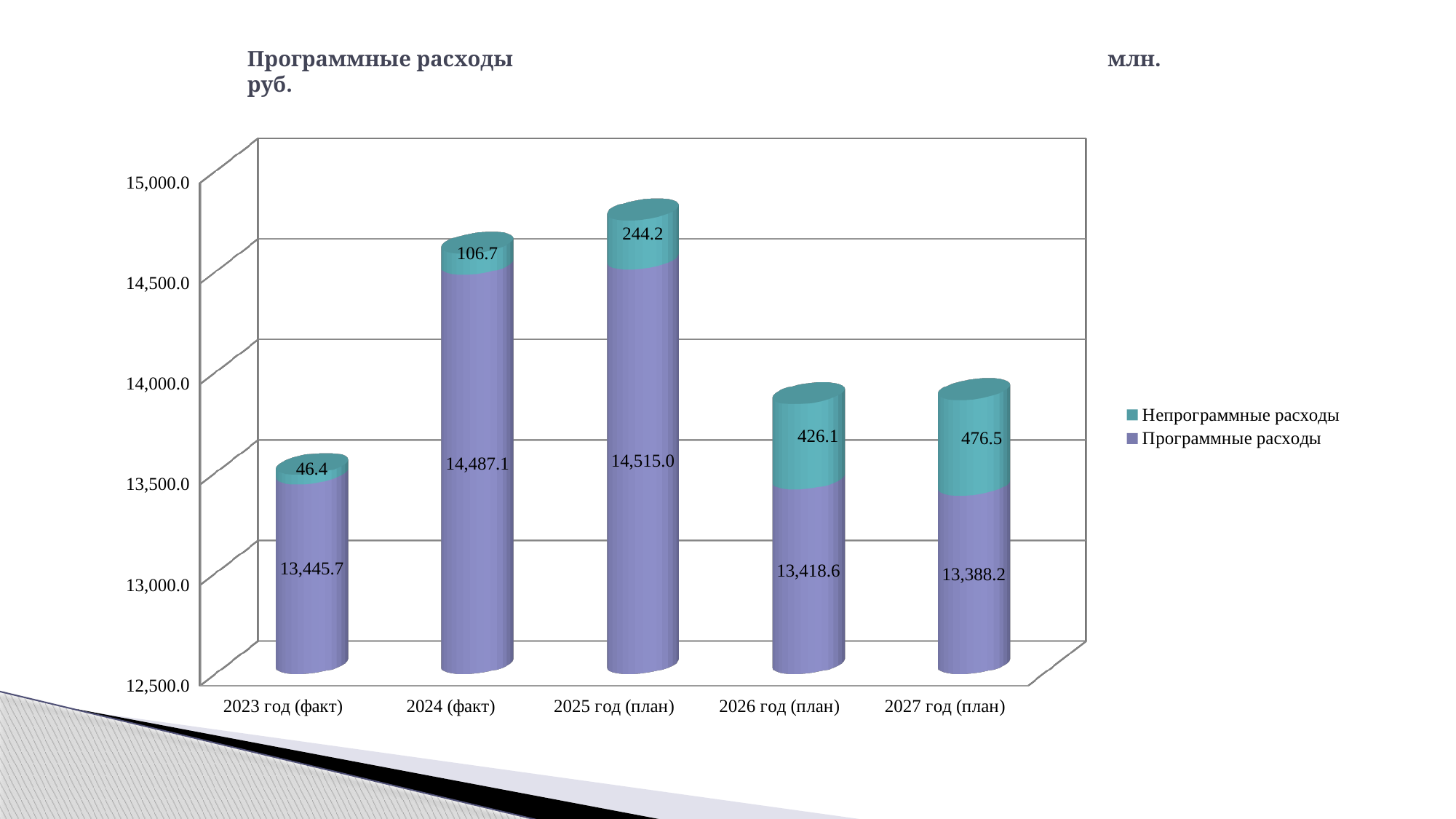
How many categories are shown on the x axis? 5 What kind of chart is shown on the slide? Stacked bar chart Which category has the lowest value of Программные расходы? 2027 год (план) Which is larger: Непрограммные расходы for 2026 год (план) or for 2025 год (план)? 2026 год (план) What is the total of the stacked bar for 2026 год (план)? 13,844.7 What is the value of Непрограммные расходы for 2027 год (план)? 476.5 What is the difference between Программные расходы for 2025 год (план) and 2024 (факт)? 27.9 What is the value of Программные расходы for 2025 год (план)? 14,515.0 What is the value of Программные расходы for 2023 год (факт)? 13,445.7 What is the total of the stacked bar for 2023 год (факт)? 13,492.1 Which category has the highest value of Непрограммные расходы? 2027 год (план) How many series does the legend list? 2